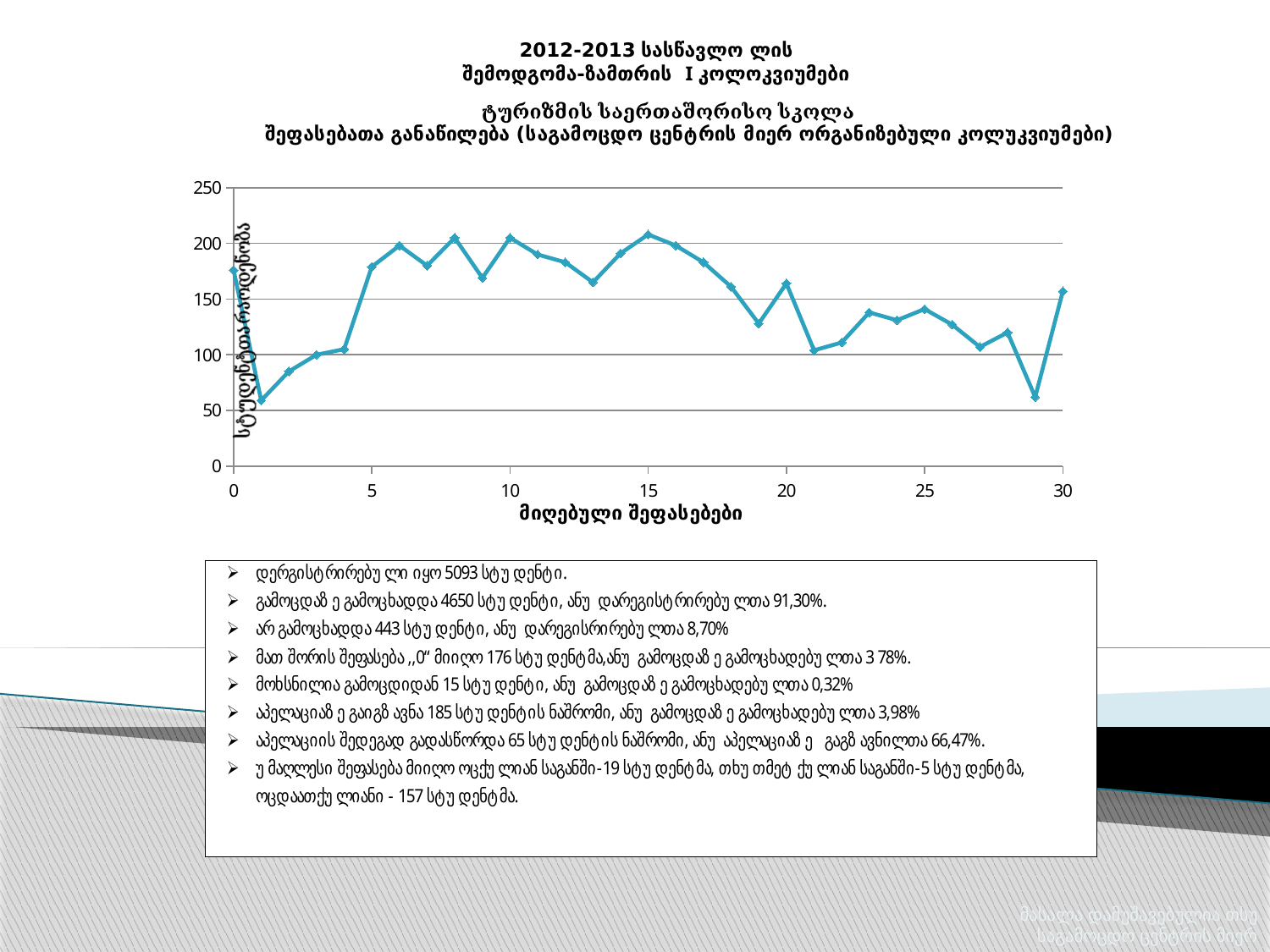
Is the value at x = 3 greater or less than 150? less Do the values rise or fall between x = 1 and x = 6? rise What is the label of the x axis? მიღებული შეფასებები Which has the larger value, x = 29 or x = 30? x = 30 Which has the larger value, x = 19 or x = 20? x = 20 What is the highest value shown on the y axis? 250 Is the value at x = 1 greater or less than 100? less Is the value at x = 6 greater or less than 150? greater Which has the larger value, x = 1 or x = 6? x = 6 What kind of chart is shown on the slide? line chart